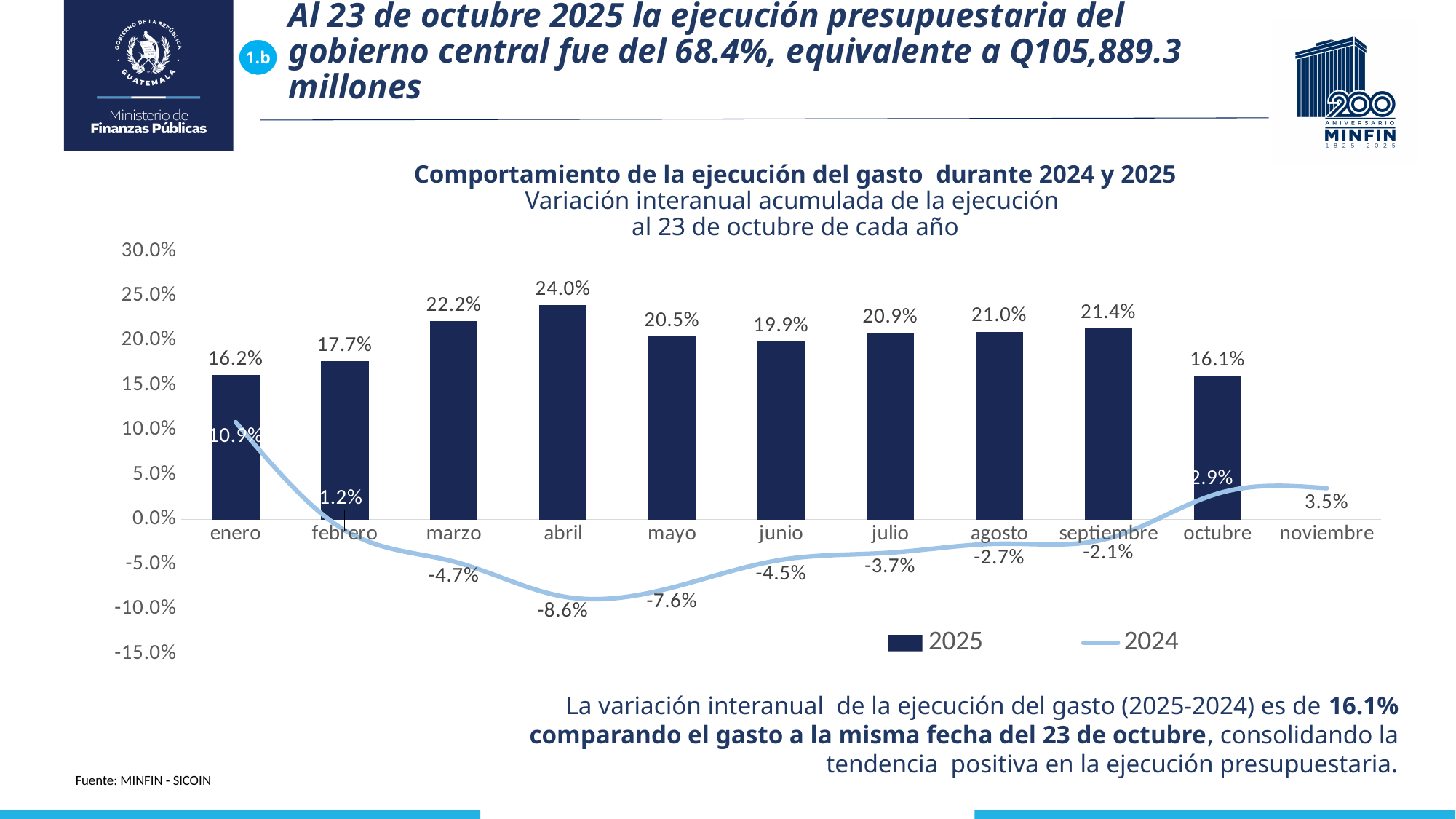
What is the difference between the 2025 values for abril and octubre? 7.9% Does the 2024 line rise or fall from enero to abril? fall Which month has the highest 2025 value? abril What kind of chart is shown? Combined bar and line chart How many months have a 2025 bar? 10 What is the 2024 value for abril? -8.6% What is the 2025 value for abril? 24.0% What is the 2024 value for noviembre? 3.5% What is the 2025 value for octubre? 16.1% Which is larger, the 2025 value for marzo or the 2025 value for mayo? marzo Which month has the lowest 2024 value? abril How many series does the legend list? 2